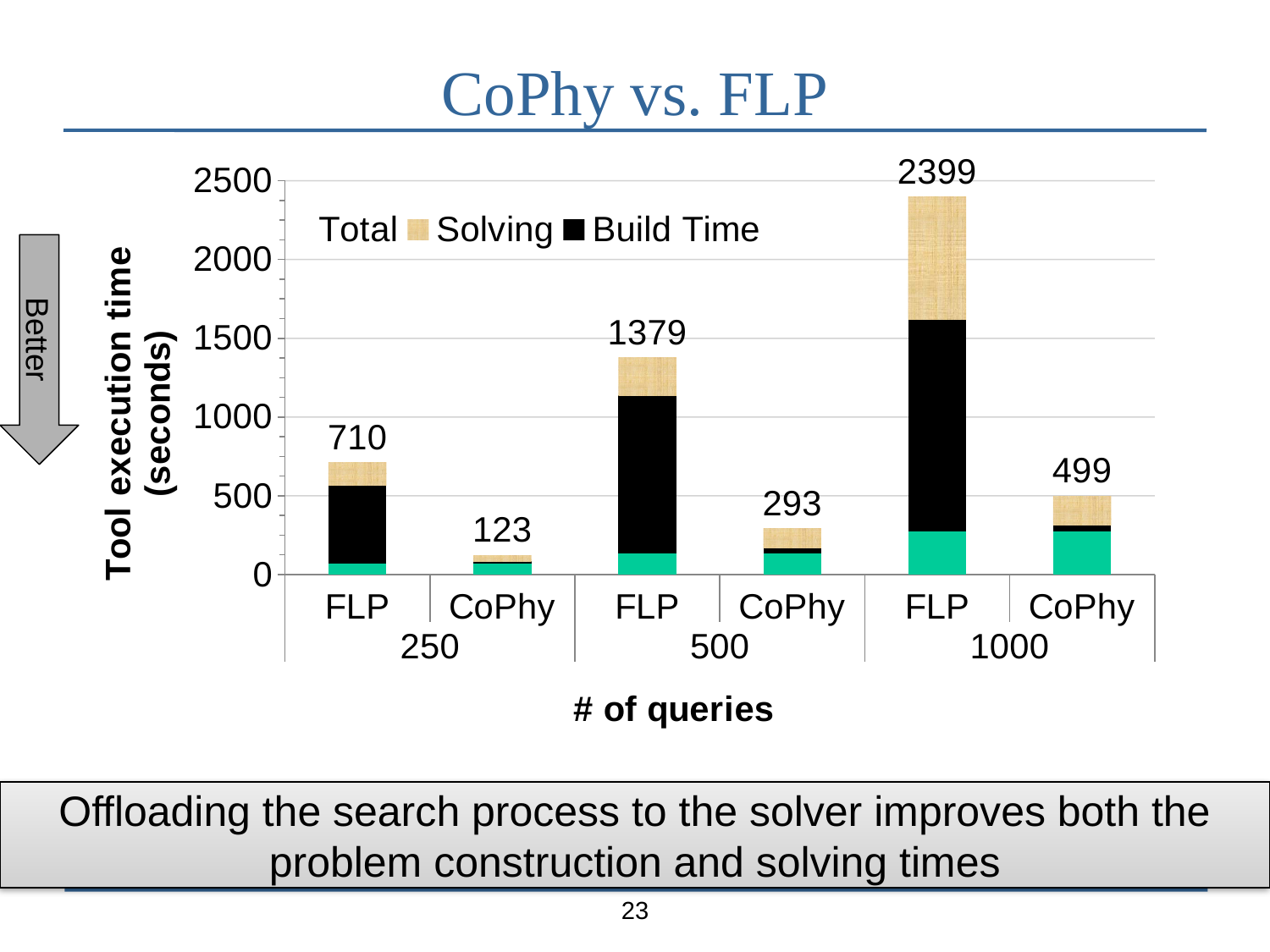
Which has a larger total time at 250 queries, FLP or CoPhy? FLP What is the difference between the total times of FLP and CoPhy at 500 queries? 1086 Which bar has the lowest total tool execution time? CoPhy at 250 queries What is the total tool execution time for CoPhy at 1000 queries? 499 What is the difference between the total times of FLP and CoPhy at 1000 queries? 1900 Which bar has the highest total tool execution time? FLP at 1000 queries How many bars are plotted in the chart? 6 What is the total tool execution time for CoPhy at 500 queries? 293 What kind of chart is shown on the slide? Stacked bar chart What is the total tool execution time for FLP at 250 queries? 710 What is the label of the x axis? # of queries